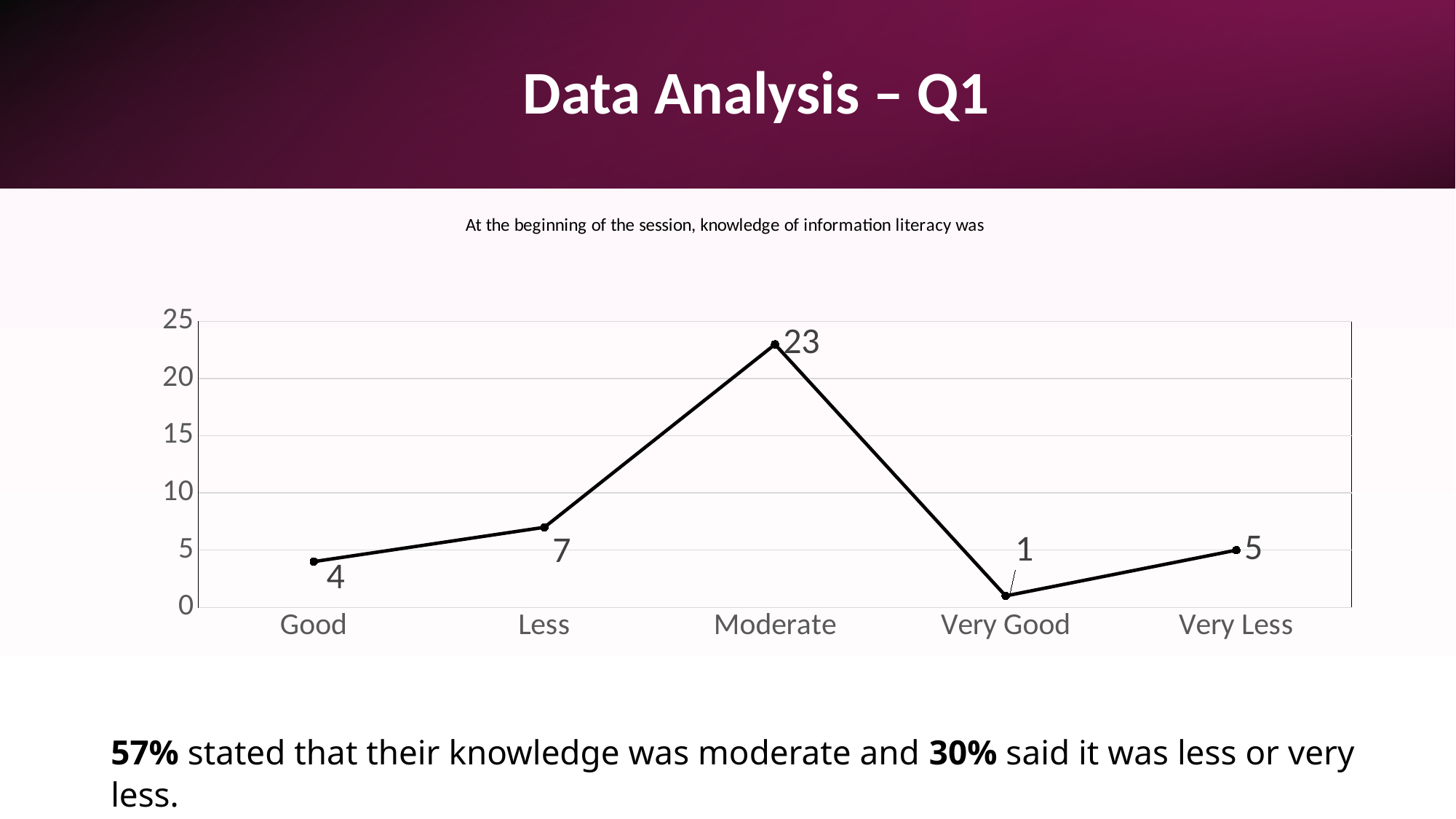
Which category has the lowest value? Very Good What is the difference between the values for Moderate and Less? 16 What is the title of the chart? At the beginning of the session, knowledge of information literacy was What is the value for Good? 4 Is the value for Moderate greater or less than 20? greater How many categories are shown on the x axis? 5 Which category has the highest value? Moderate What is the value for Less? 7 What kind of chart is shown on the slide? line chart What is the value for Moderate? 23 Which is larger, the value for Less or the value for Very Less? Less What is the value for Very Less? 5